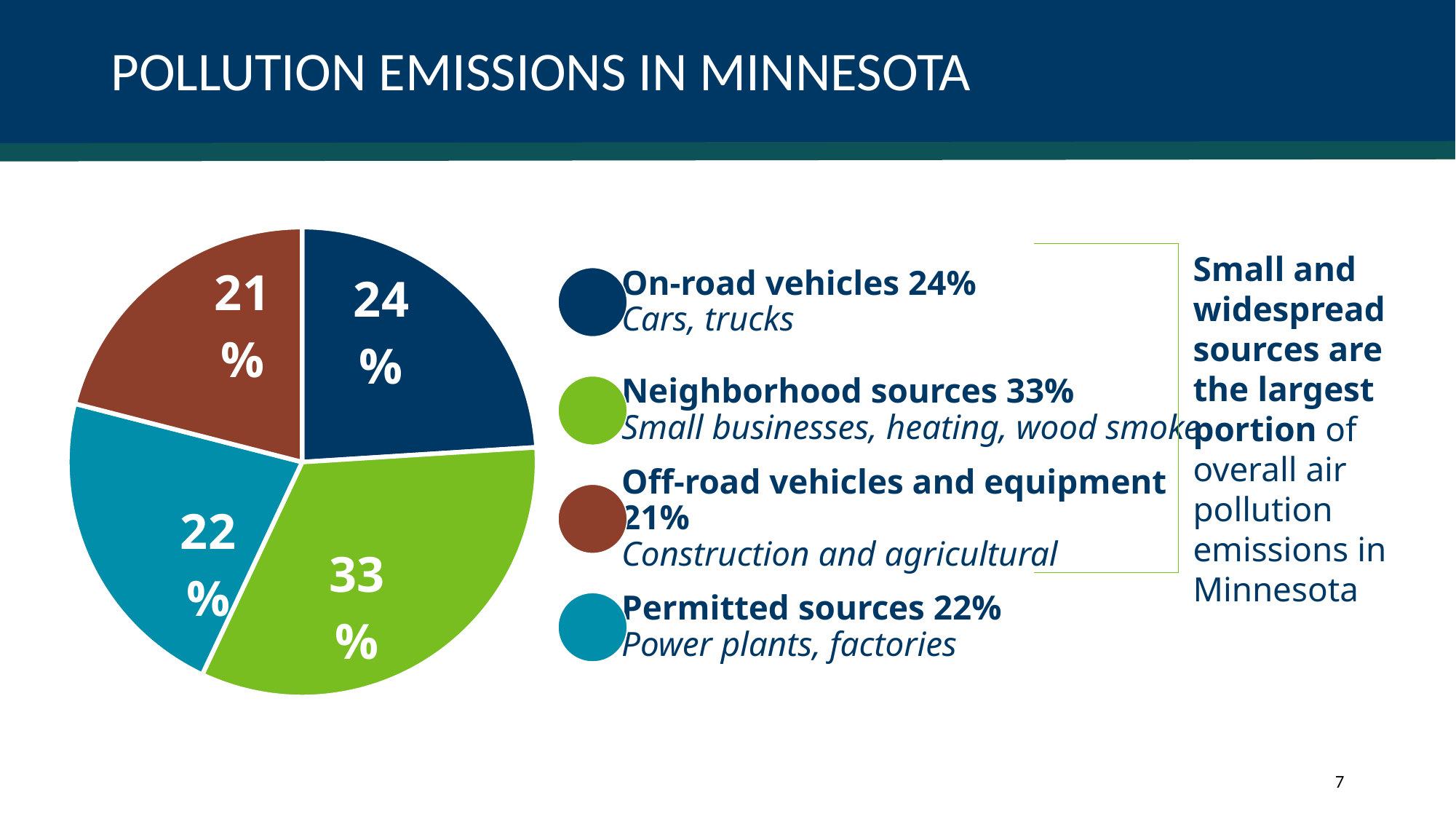
What share of pollution emissions comes from Neighborhood sources? 33% What share of pollution emissions comes from Off-road vehicles and equipment? 21% Which source accounts for the smallest share of pollution emissions? Off-road vehicles and equipment How many slices does the pie chart have? 4 What is the difference in percentage points between Neighborhood sources and On-road vehicles? 9 What examples are listed for Permitted sources in the legend? Power plants, factories Which source accounts for the largest share of pollution emissions? Neighborhood sources What share of pollution emissions comes from Permitted sources? 22% Which is larger, the share for On-road vehicles or the share for Permitted sources? On-road vehicles What share of pollution emissions comes from On-road vehicles? 24% What colour is the slice for Permitted sources? teal What kind of chart is shown on the slide? pie chart